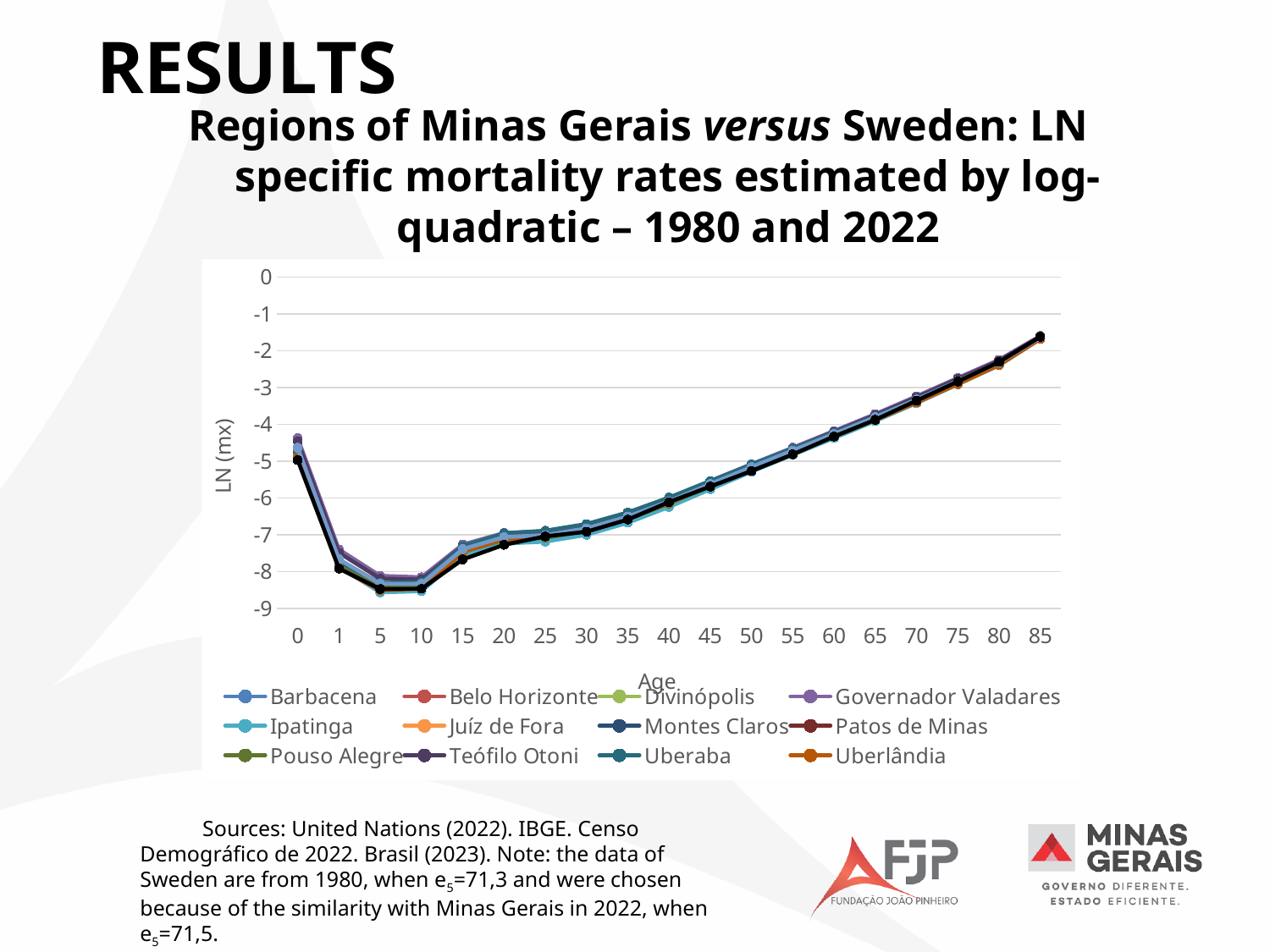
Is the value for Barbacena at age 0 greater or less than -6? greater At which age do the lines reach their highest value? 85 What is the label of the y axis? LN (mx) How many age categories are shown on the x axis? 19 Do the values rise or fall along the x axis from age 0 to age 1? fall Is the value for Montes Claros at age 85 greater or less than -2? greater What is the label of the x axis? Age How many series does the legend list? 12 Is the value for Montes Claros at age 5 greater or less than -8? less Which is larger for Montes Claros: the value at age 0 or the value at age 1? age 0 Do the values rise or fall along the x axis from age 10 to age 85? rise What kind of chart is shown on the slide? line chart